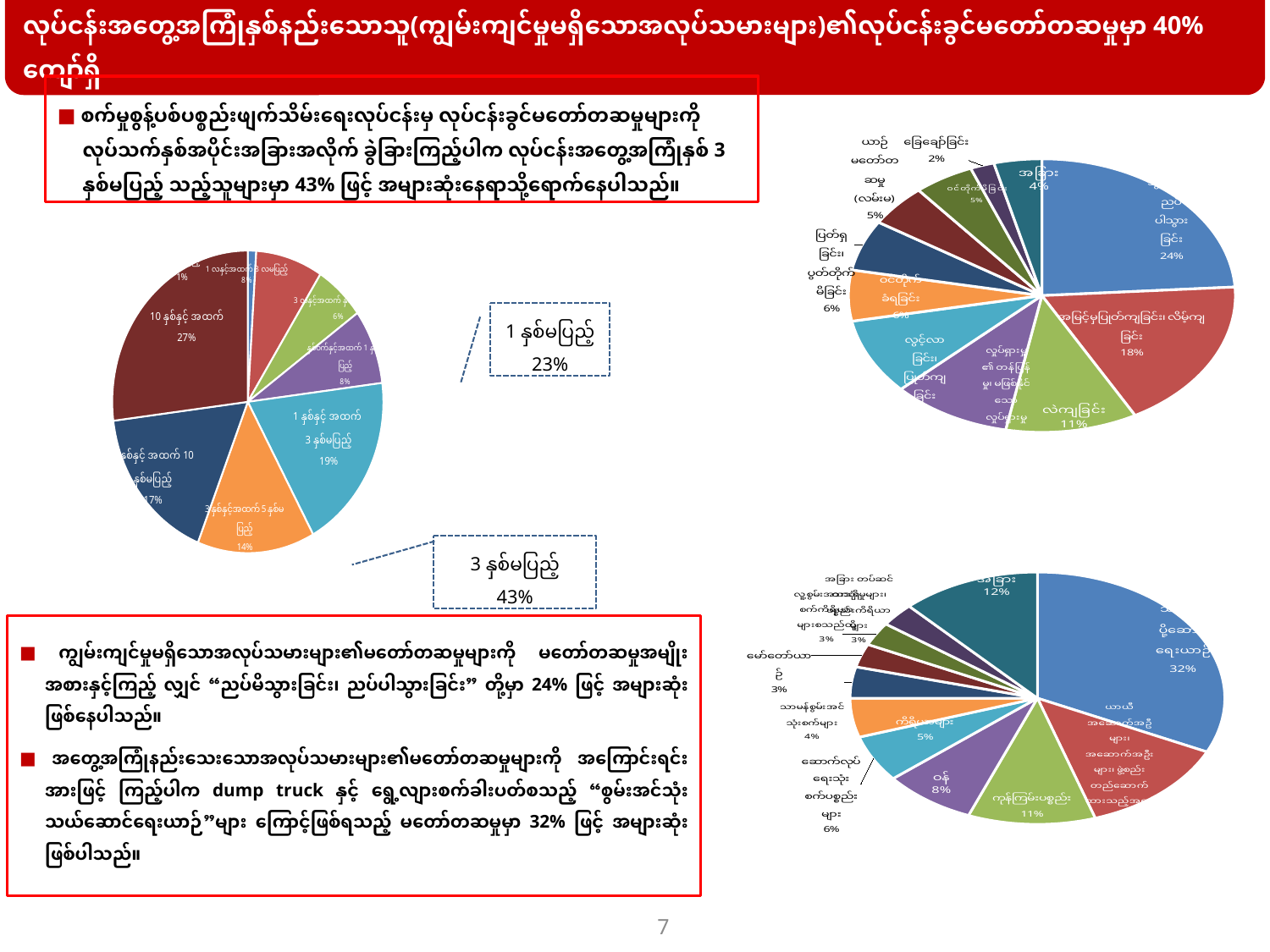
In the top-right pie chart, what share is shown for the slice labelled "လဲကျခြင်း"? 11% In the bottom-right pie chart, which is larger: the "ကုန်ကြမ်းပစ္စည်း" slice or the "ဝန်" slice? ကုန်ကြမ်းပစ္စည်း According to the callout next to the left pie chart, what share of workers have less than 1 year of experience ("1 နှစ်မပြည့်")? 23% In the top-right pie chart, what share is shown for the slice labelled "ညပ်မိသွားခြင်း၊ ညပ်ပါသွားခြင်း"? 24% According to the callout next to the left pie chart, what share of workers have less than 3 years of experience ("3 နှစ်မပြည့်")? 43% In the left pie chart, what is the difference in percentage points between the "10 နှစ်နှင့် အထက်" slice (27%) and the "5 နှစ်နှင့် အထက် 10 နှစ်မပြည့်" slice (17%)? 10 percentage points What kind of chart is the chart on the left of the slide? Pie chart In the bottom-right pie chart, what share is shown for the largest slice, "စွမ်းအင်သုံး သယ်ဆောင်ရေးယာဉ်"? 32% How many charts are shown on the slide? 3 In the left pie chart, which slice has the largest share? 10 နှစ်နှင့် အထက် In the left pie chart, what share is shown for the slice labelled "1 နှစ်နှင့် အထက် 3 နှစ်မပြည့်"? 19% In the left pie chart, what share is shown for the slice labelled "10 နှစ်နှင့် အထက်"? 27%